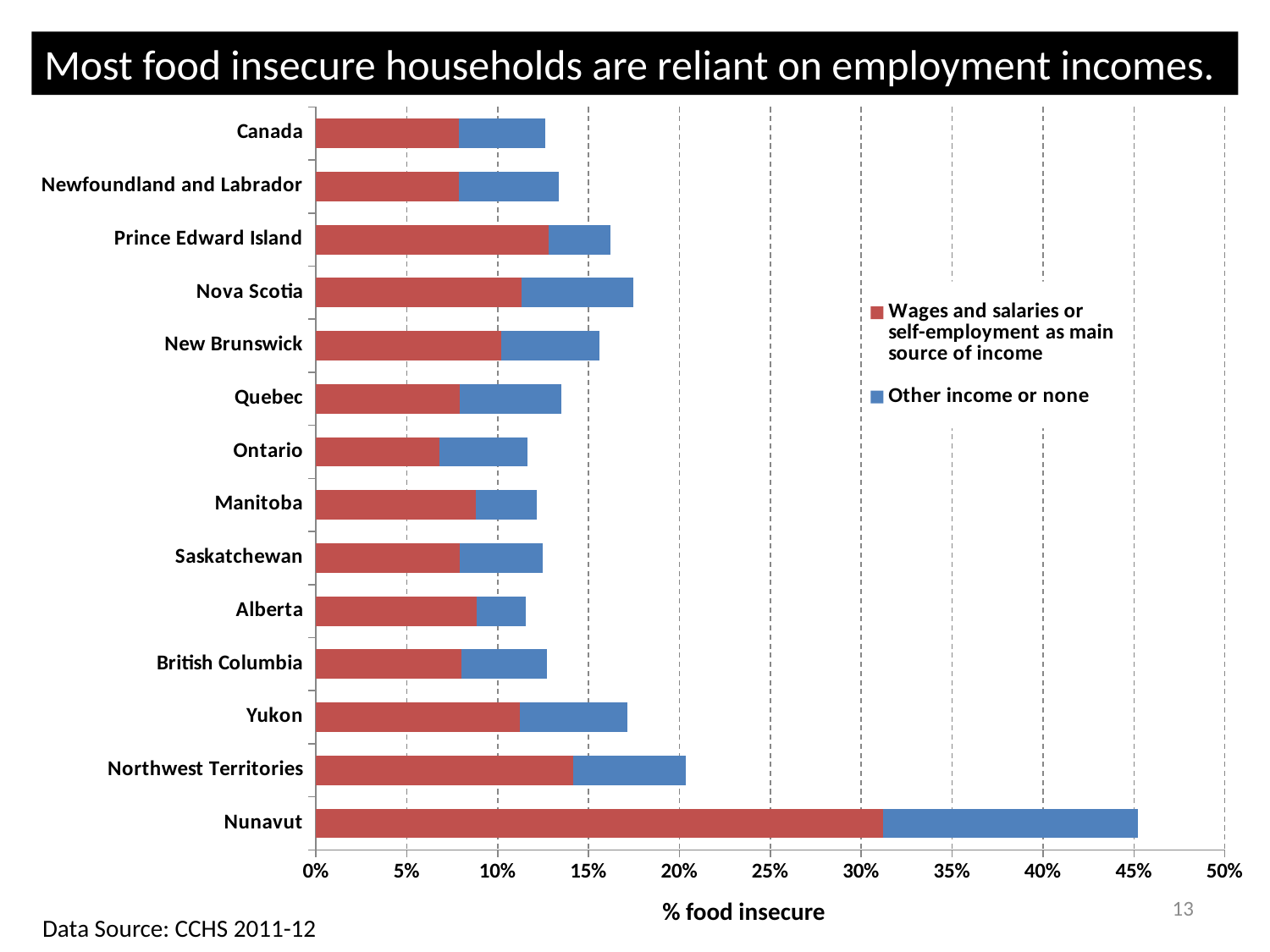
Which region has the highest total percentage of food insecure households? Nunavut Which has a larger total value, Nunavut or Northwest Territories? Nunavut Is the total value for Northwest Territories greater or less than 15%? greater Which has a larger total value, Nova Scotia or Canada? Nova Scotia What is the label on the horizontal axis of the chart? % food insecure Which series is shown in blue in the chart's legend? Other income or none How many provinces/territories (including Canada) are listed on the vertical axis of the chart? 14 How many series does the chart's legend list? 2 Is the total value for Nunavut greater or less than 40%? greater What kind of chart is shown on the slide? Stacked bar chart Is the total value for Canada greater or less than 15%? less